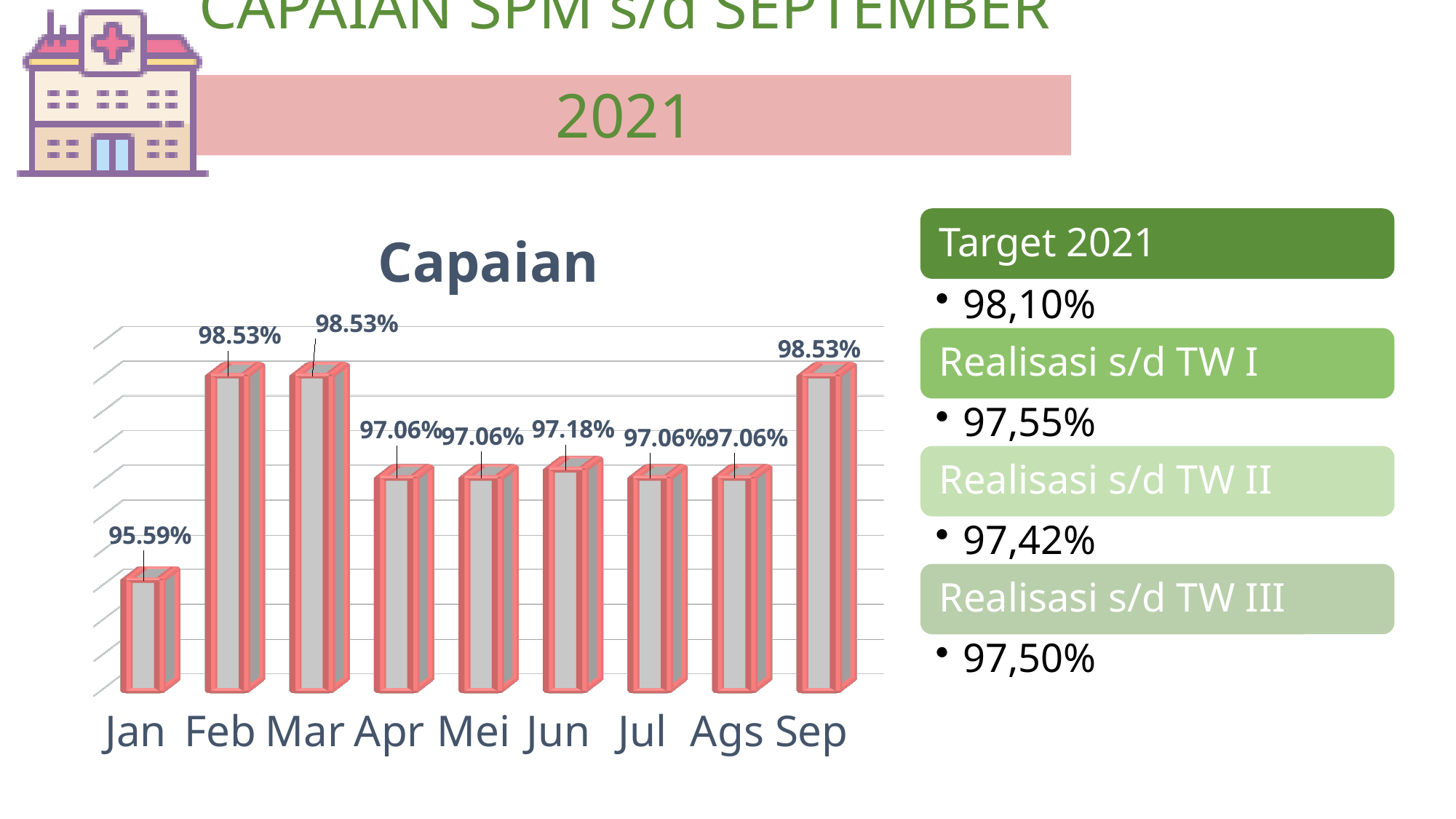
What is the value for Sep in the Capaian chart? 98.53% What is the value for Jan in the Capaian chart? 95.59% How many months are shown on the x axis of the Capaian chart? 9 Does the value rise or fall from Jan to Feb in the Capaian chart? rise What is the difference between the values for Jun and Apr in the Capaian chart? 0.12% What kind of chart is the Capaian chart? bar chart What is the difference between the values for Feb and Jan in the Capaian chart? 2.94% Which month has the lowest value in the Capaian chart? Jan Which is larger in the Capaian chart, the value for Jan or the value for Apr? Apr What is the value for Jun in the Capaian chart? 97.18% What is the value for Feb in the Capaian chart? 98.53% What is the value for Apr in the Capaian chart? 97.06%